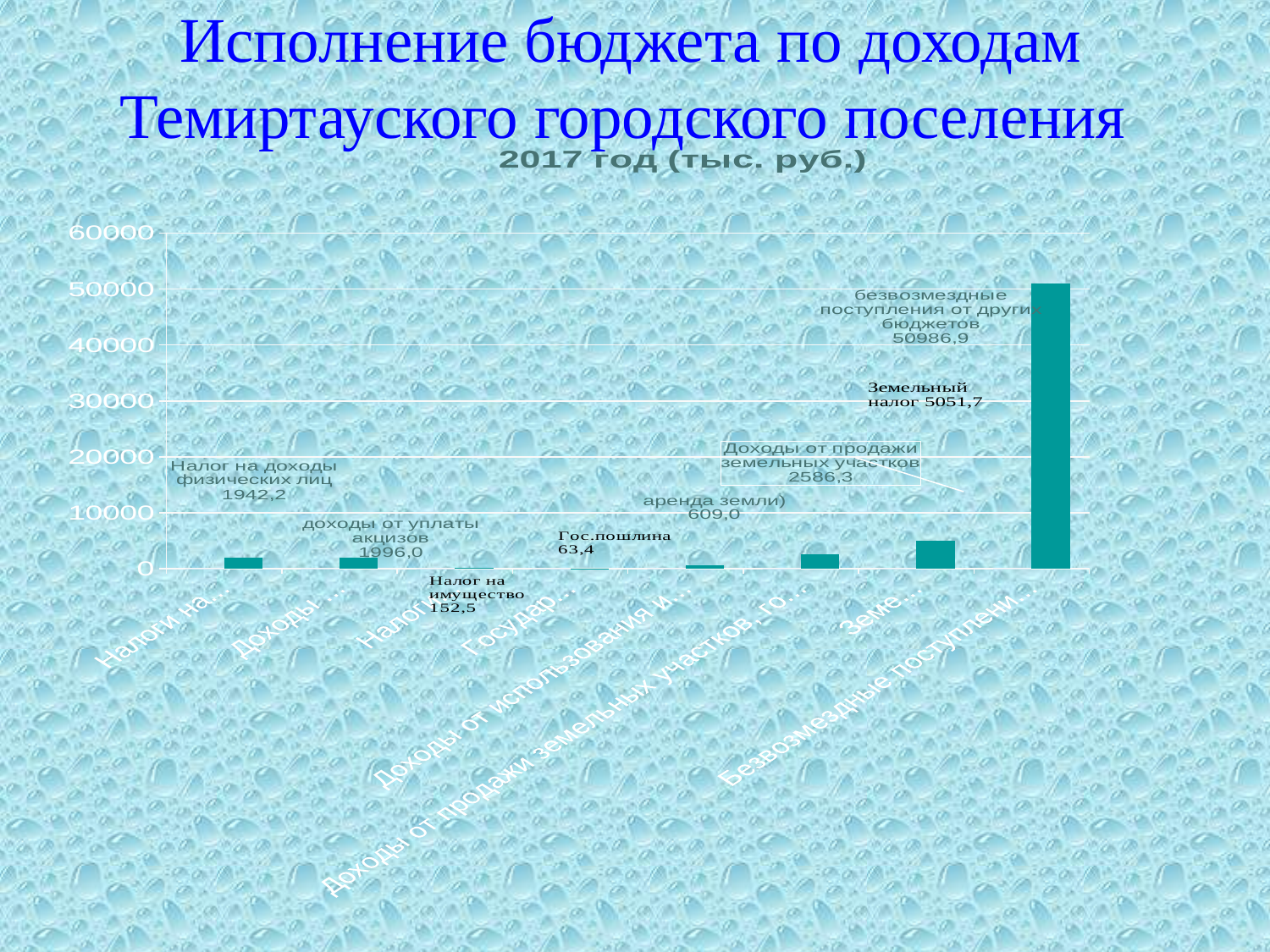
Which category has the highest value? безвозмездные поступления от других бюджетов Which category has the lowest value? Гос.пошлина How many bars are plotted in the chart? 8 What is the difference between Земельный налог (5051,7) and Доходы от продажи земельных участков (2586,3)? 2465,4 Is the value for безвозмездные поступления от других бюджетов greater or less than 40000? greater What is the value labelled for Гос.пошлина? 63,4 What is the value labelled for Налог на имущество? 152,5 What is the value labelled for Доходы от продажи земельных участков? 2586,3 What is the chart's title? 2017 год (тыс. руб.) What kind of chart is shown on the slide? bar chart What is the value labelled for Земельный налог? 5051,7 What is the value labelled for безвозмездные поступления от других бюджетов? 50986,9